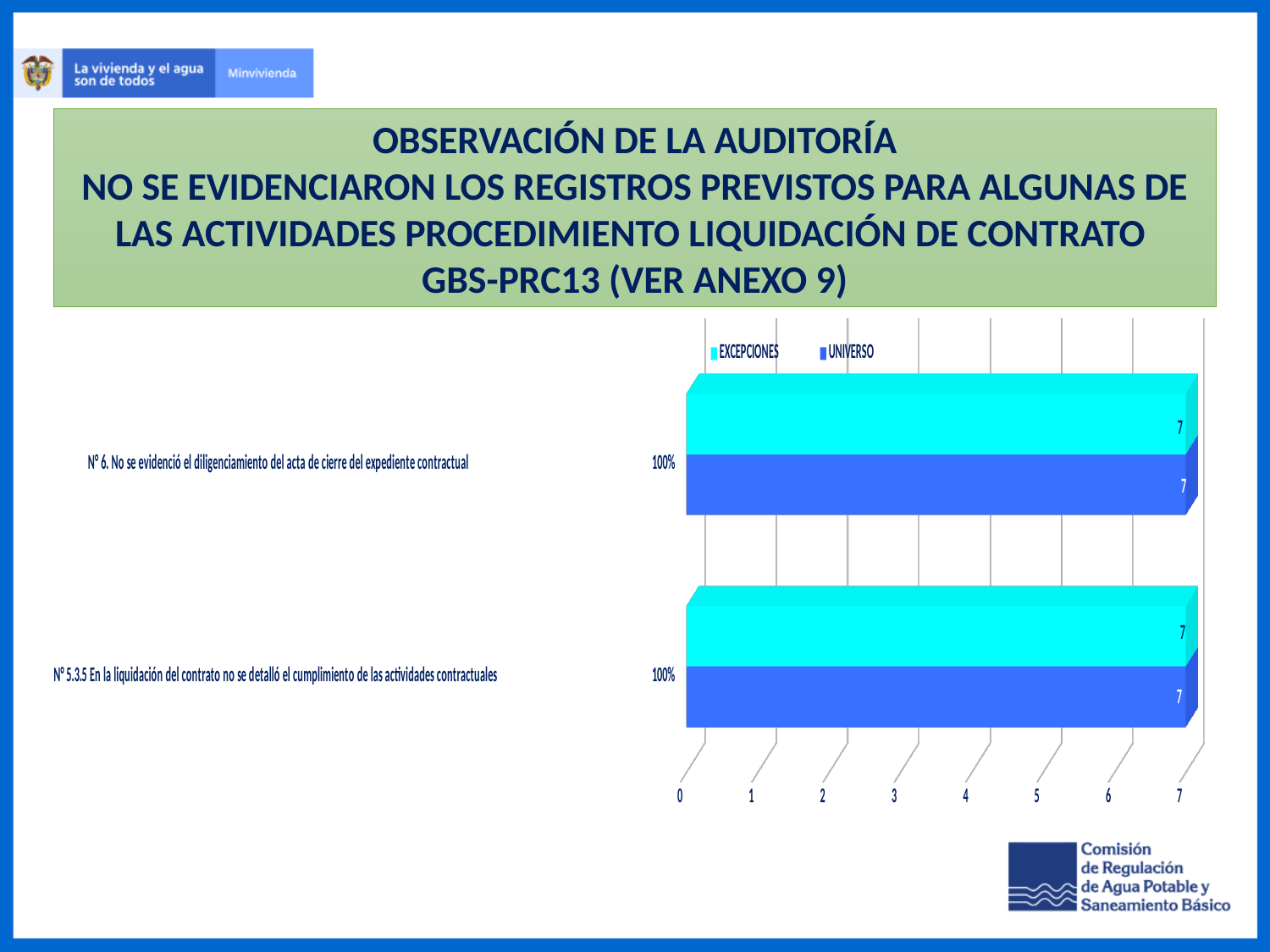
How many categories are plotted in the chart? 2 What is the EXCEPCIONES value for 'N° 6. No se evidenció el diligenciamiento del acta de cierre del expediente contractual'? 7 What kind of chart is shown on the slide? bar chart What are the two series named in the chart legend? EXCEPCIONES and UNIVERSO What percentage is shown next to the category 'N° 6. No se evidenció el diligenciamiento del acta de cierre del expediente contractual'? 100% What is the UNIVERSO value for 'N° 5.3.5 En la liquidación del contrato no se detalló el cumplimiento de las actividades contractuales'? 7 How many series does the chart legend list? 2 Is the UNIVERSO value for 'N° 6. No se evidenció el diligenciamiento del acta de cierre del expediente contractual' greater or less than 5? greater What is the UNIVERSO value for 'N° 6. No se evidenció el diligenciamiento del acta de cierre del expediente contractual'? 7 Which colour represents the EXCEPCIONES series in the chart? cyan (light blue) What is the difference between the EXCEPCIONES and UNIVERSO values for 'N° 5.3.5 En la liquidación del contrato no se detalló el cumplimiento de las actividades contractuales'? 0 What is the EXCEPCIONES value for 'N° 5.3.5 En la liquidación del contrato no se detalló el cumplimiento de las actividades contractuales'? 7